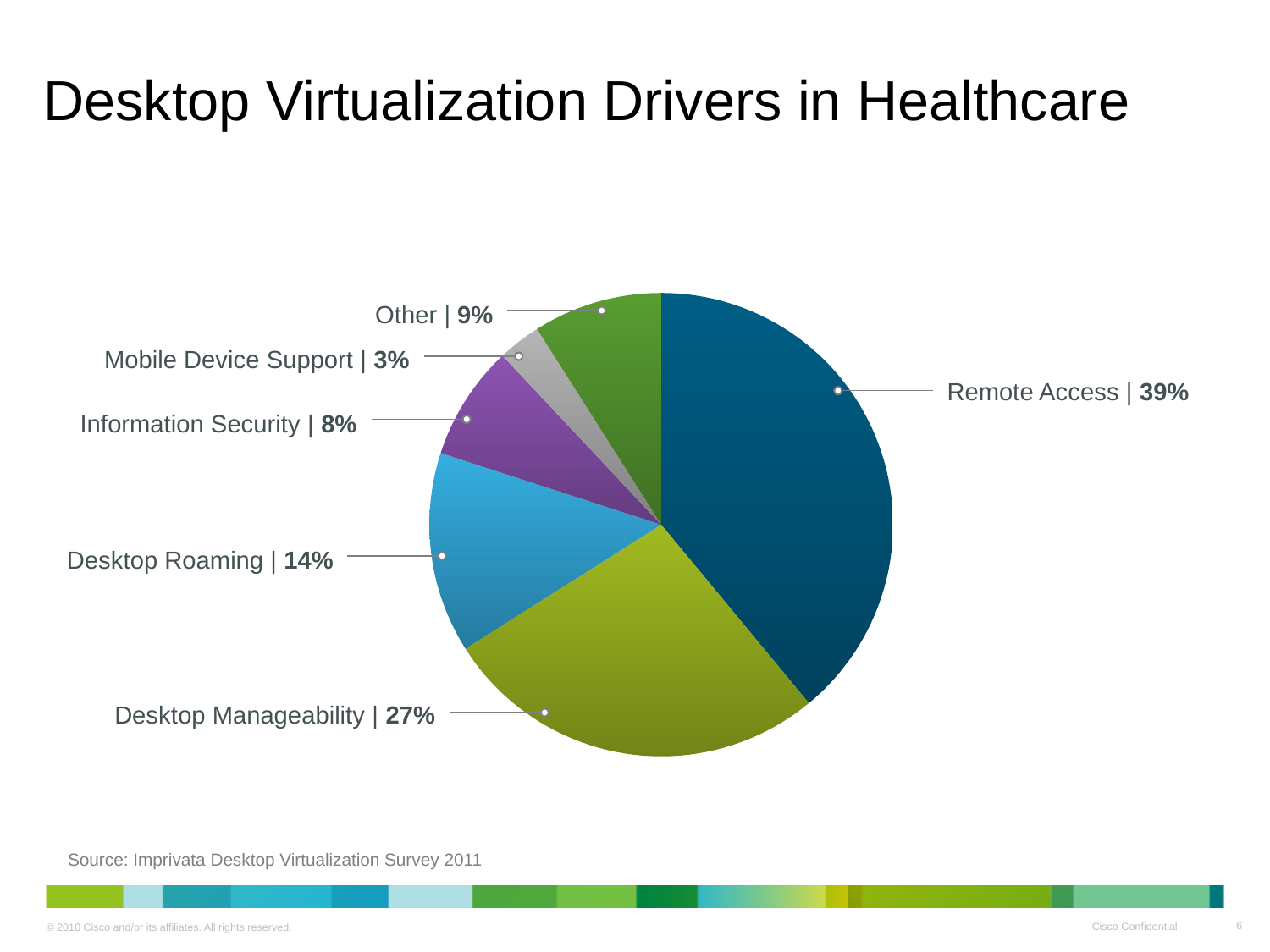
What is the value for Desktop Manageability? 27% What is the value for Desktop Roaming? 14% Which category has the smallest share of the pie? Mobile Device Support What kind of chart is shown on the slide? Pie chart Which category has the largest share of the pie? Remote Access What is the value for Mobile Device Support? 3% What share of the pie does Remote Access represent? 39% What is the title of the slide? Desktop Virtualization Drivers in Healthcare How many categories are shown in the pie chart? 6 What is the difference between the Desktop Roaming and Information Security shares? 6% What is the difference between the Remote Access and Desktop Manageability shares? 12% Which is larger, the share for Other or the share for Information Security? Other